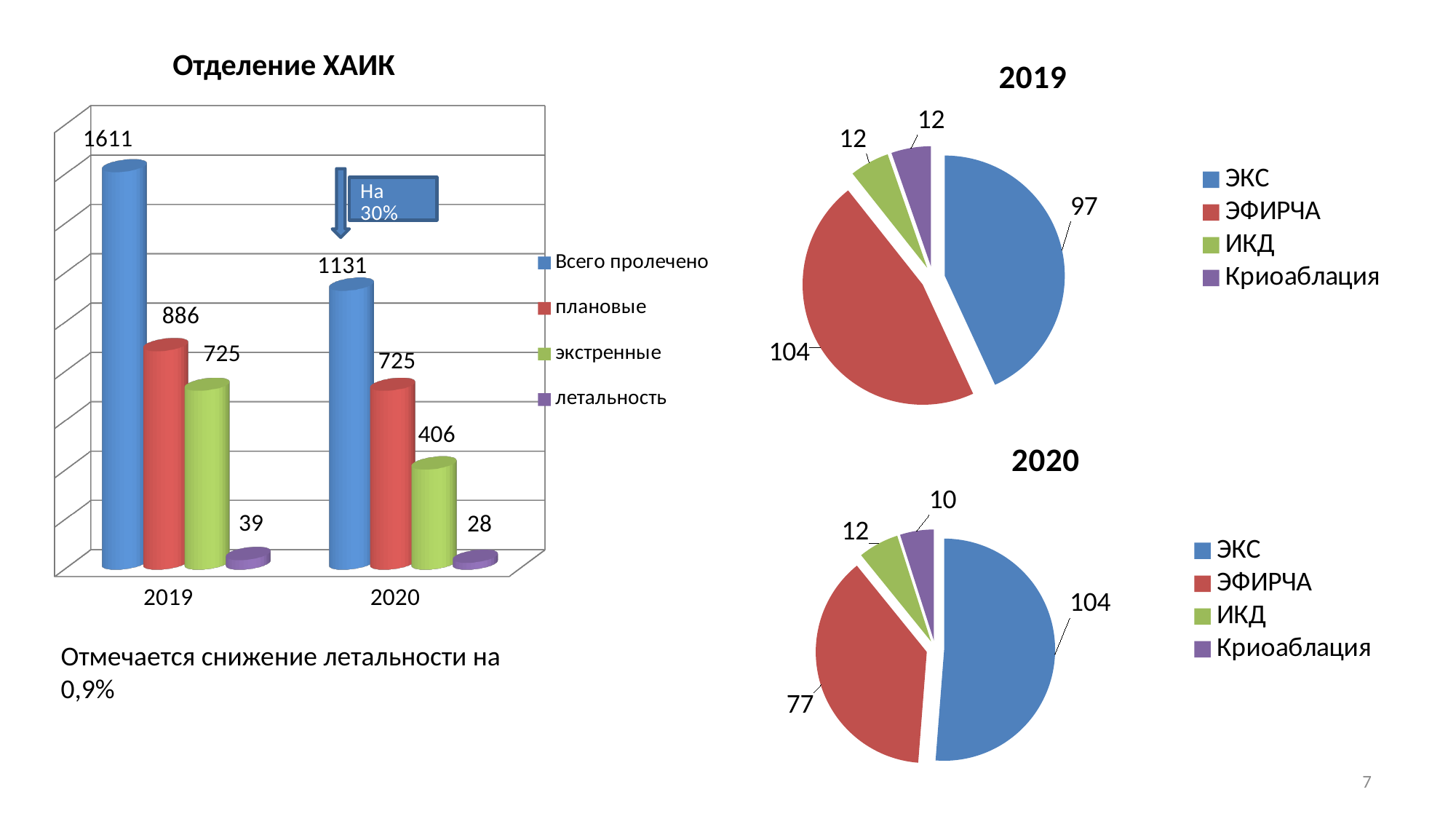
In the pie chart '2019', what is the value for 'ЭФИРЧА'? 104 In the pie chart '2020', what is the value for 'Криоаблация'? 10 In the bar chart 'Отделение ХАИК', by how much did 'Всего пролечено' change from 2019 to 2020? 480 In the bar chart 'Отделение ХАИК', what is the value of 'летальность' for 2019? 39 In the pie chart '2019', which category has the largest slice? ЭФИРЧА In the pie chart '2020', what is the difference between 'ЭКС' and 'ЭФИРЧА'? 27 In the pie chart '2020', which category has the smallest slice? Криоаблация In the bar chart 'Отделение ХАИК', how many series does the legend list? 4 In the bar chart 'Отделение ХАИК', what is the value of 'экстренные' for 2020? 406 What type of chart is 'Отделение ХАИК'? bar chart In the bar chart 'Отделение ХАИК', which is larger: 'плановые' in 2019 or 'плановые' in 2020? 2019 In the bar chart 'Отделение ХАИК', what is the value of 'Всего пролечено' for 2019? 1611